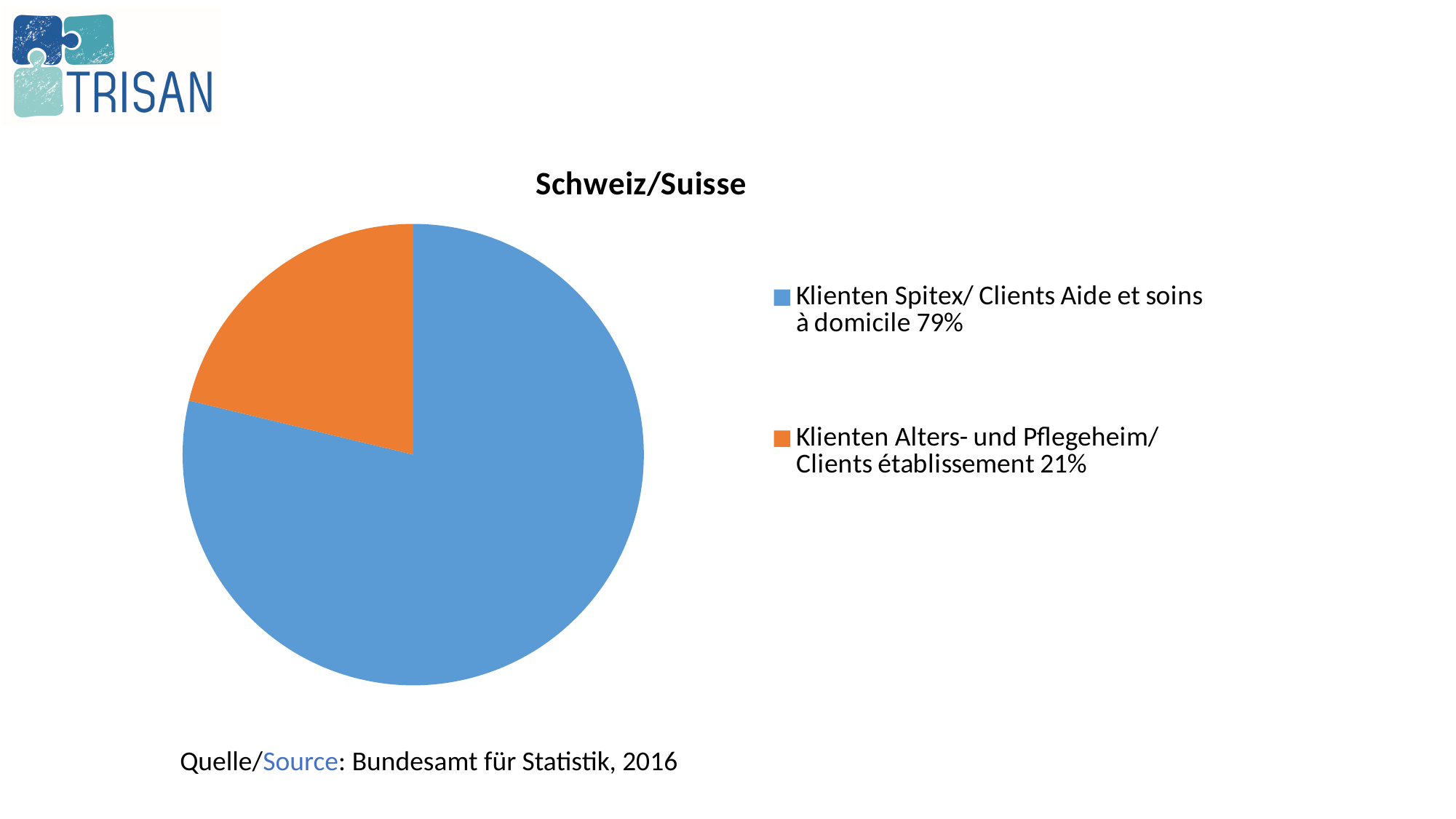
What kind of chart is shown on the slide? pie chart What is the title of the chart? Schweiz/Suisse What share of the pie is Klienten Alters- und Pflegeheim/ Clients établissement? 21% What colour is the slice for Klienten Alters- und Pflegeheim/ Clients établissement? orange How many categories does the pie chart show? 2 What is the difference in percentage points between the Spitex share and the Alters- und Pflegeheim share? 58 Which category has the smallest share of the pie? Klienten Alters- und Pflegeheim/ Clients établissement Which is larger: the share for Klienten Spitex or the share for Klienten Alters- und Pflegeheim? Klienten Spitex What is the total of the two shares shown in the pie chart? 100% Which category has the largest share of the pie? Klienten Spitex/ Clients Aide et soins à domicile What share of the pie is Klienten Spitex/ Clients Aide et soins à domicile? 79%